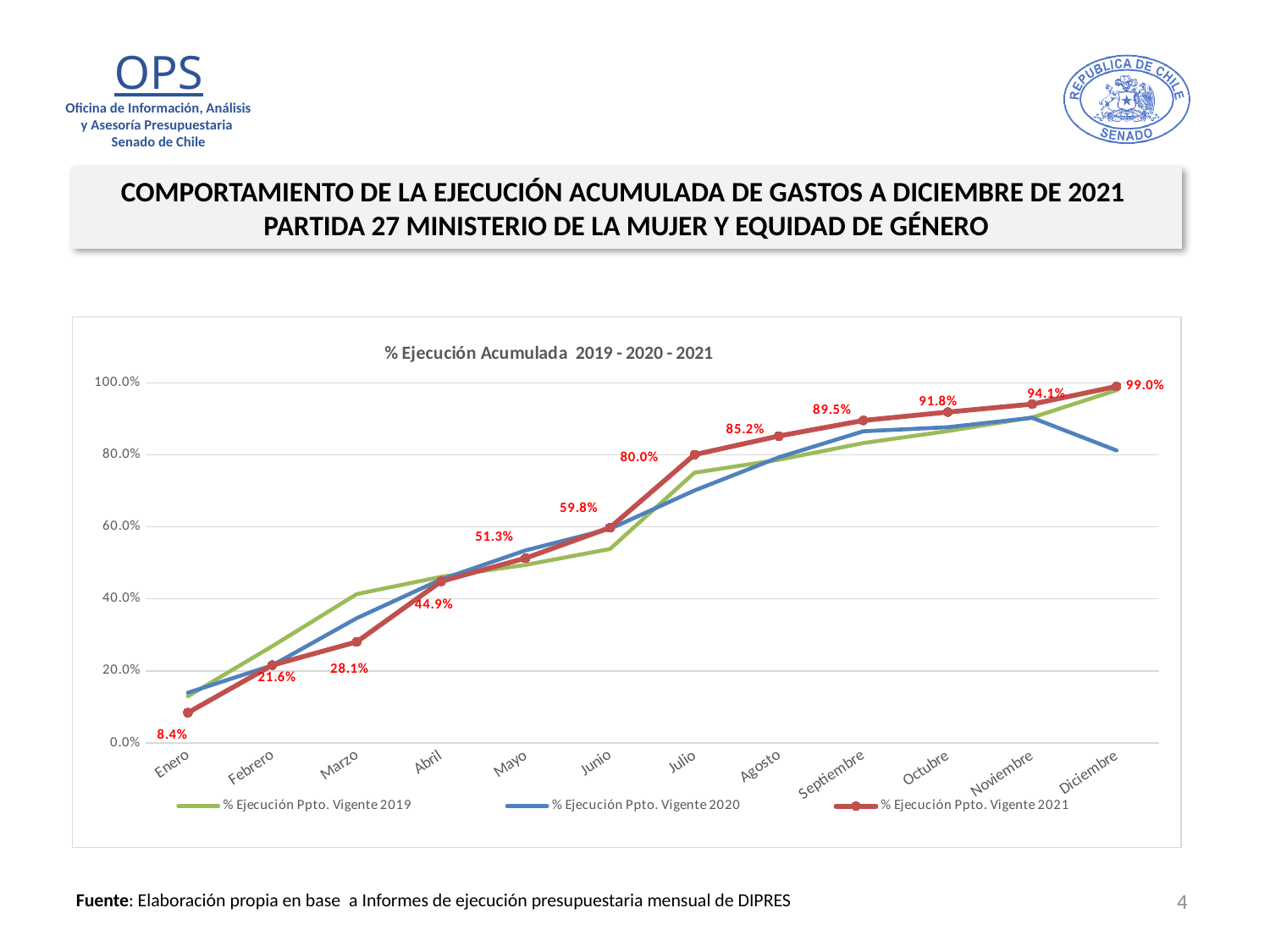
Is the value of % Ejecución Ppto. Vigente 2020 in Diciembre greater or less than 100.0%? less Which is larger in Marzo: % Ejecución Ppto. Vigente 2019 or % Ejecución Ppto. Vigente 2021? % Ejecución Ppto. Vigente 2019 How many months are shown on the x axis? 12 How many series does the legend list? 3 In which month is the % Ejecución Ppto. Vigente 2021 series lowest? Enero What is the value of % Ejecución Ppto. Vigente 2021 in Julio? 80.0% What type of chart is shown on the slide? Line chart What is the value of % Ejecución Ppto. Vigente 2021 in Enero? 8.4% Does the % Ejecución Ppto. Vigente 2021 series rise or fall from Enero to Diciembre? Rise What is the title of the chart? % Ejecución Acumulada 2019 - 2020 - 2021 What is the value of % Ejecución Ppto. Vigente 2021 in Diciembre? 99.0% What is the difference between the 2021 values for Julio and Junio? 20.2%